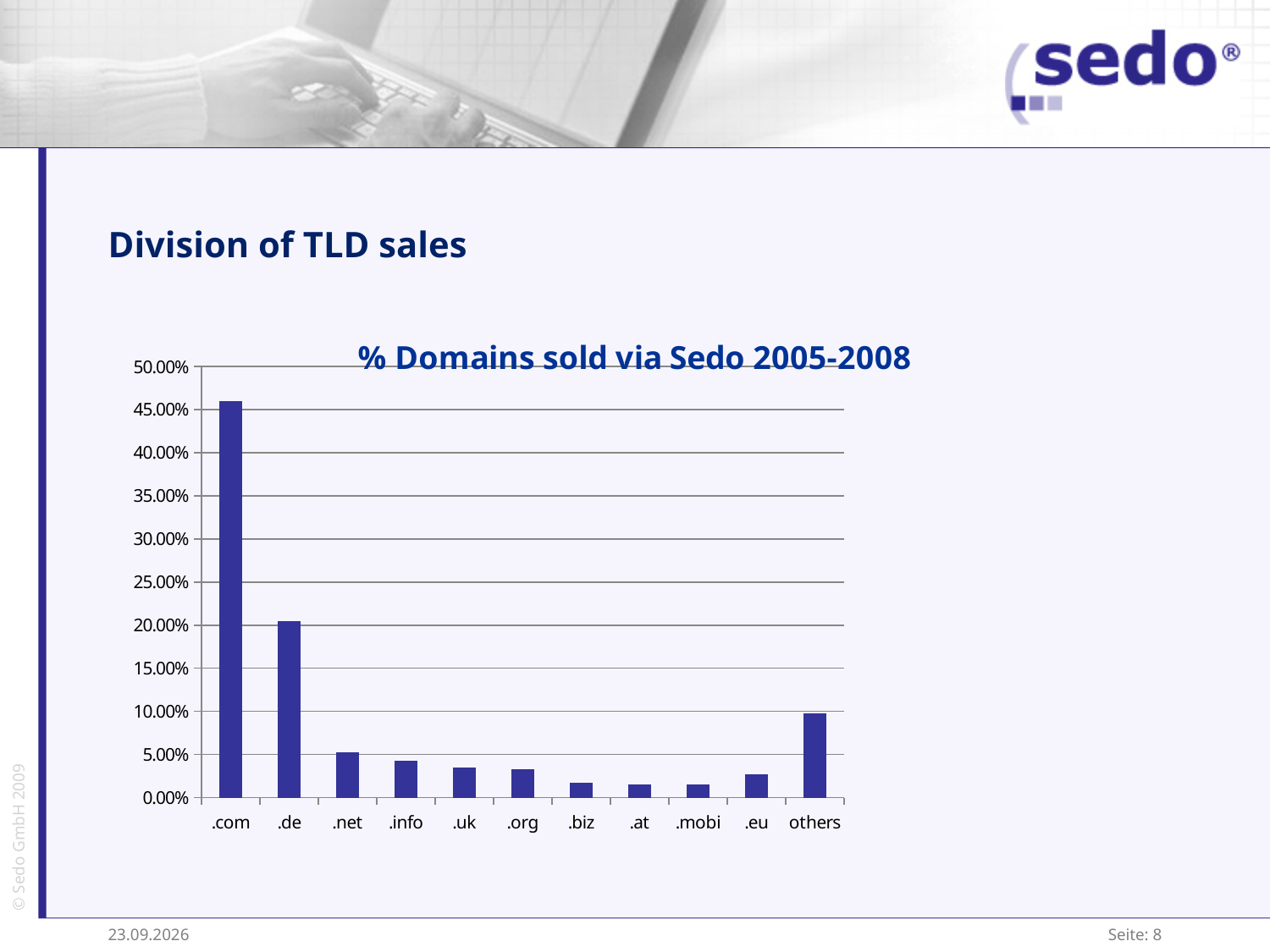
How many TLD categories are shown on the x axis of the chart? 11 Is the value for .de greater or less than 15.00%? greater Which has a larger share, .eu or .biz? .eu Is the value for others greater or less than 5.00%? greater What kind of chart is shown on the slide? bar chart Is the value for .com greater or less than 40.00%? greater What is the title of the chart? % Domains sold via Sedo 2005-2008 Which TLD has the highest share of domains sold via Sedo 2005-2008? .com Which has a larger share, others or .net? others Which has a larger share, .com or .de? .com